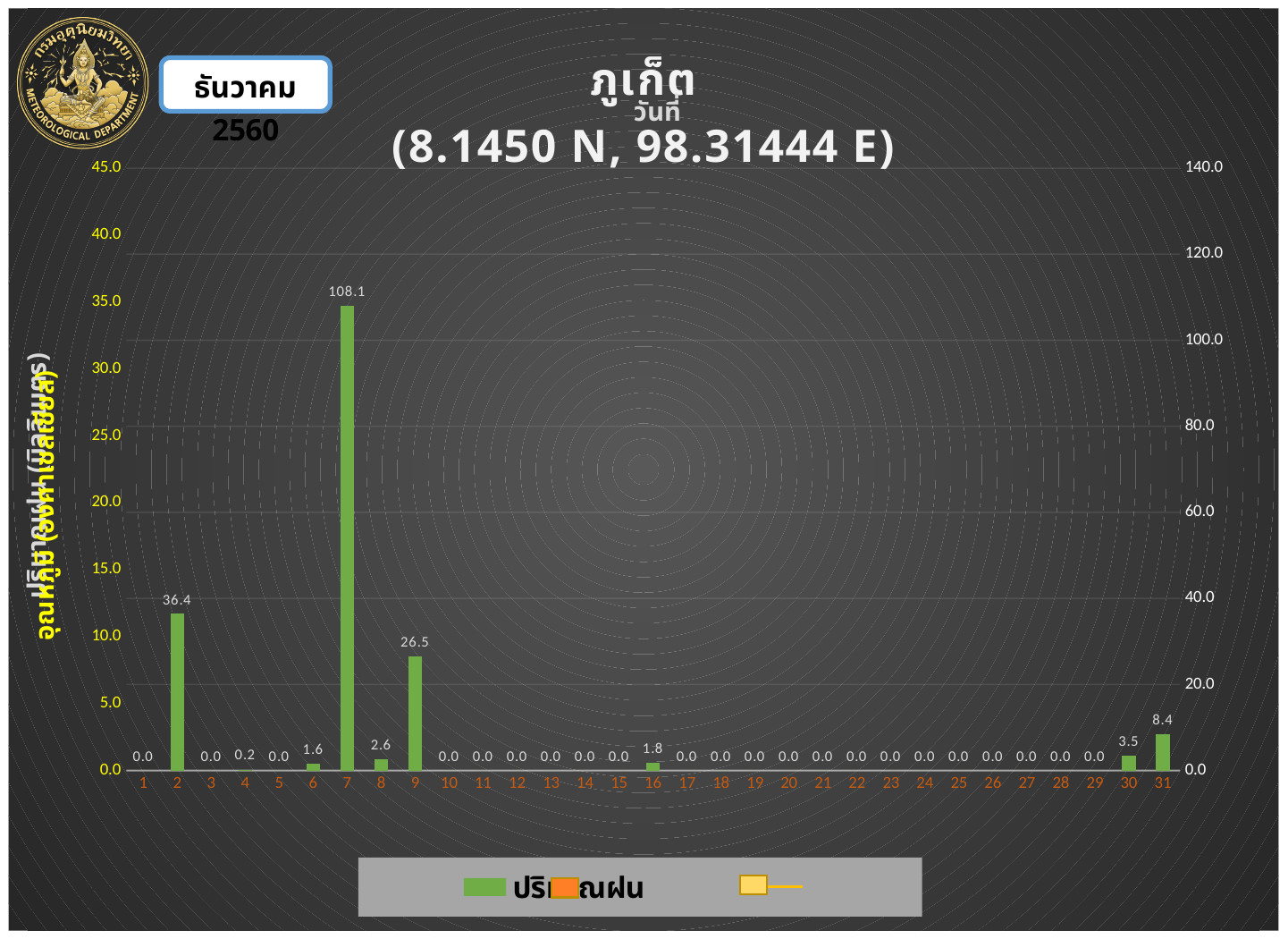
What is the rainfall value shown for day 31? 8.4 What is the rainfall value shown for day 16? 1.8 Which has the larger rainfall value, day 30 or day 31? 31 What is the difference between the rainfall values for day 7 and day 2? 71.7 What is the difference between the rainfall values for day 9 and day 31? 18.1 What kind of chart is shown on the slide? bar chart How many days are shown along the x axis? 31 Which day has the highest rainfall value? 7 What is the rainfall value shown for day 9? 26.5 What is the rainfall value shown for day 7? 108.1 Is the rainfall value for day 7 greater or less than 100.0 on the right axis? greater What is the rainfall value shown for day 2? 36.4